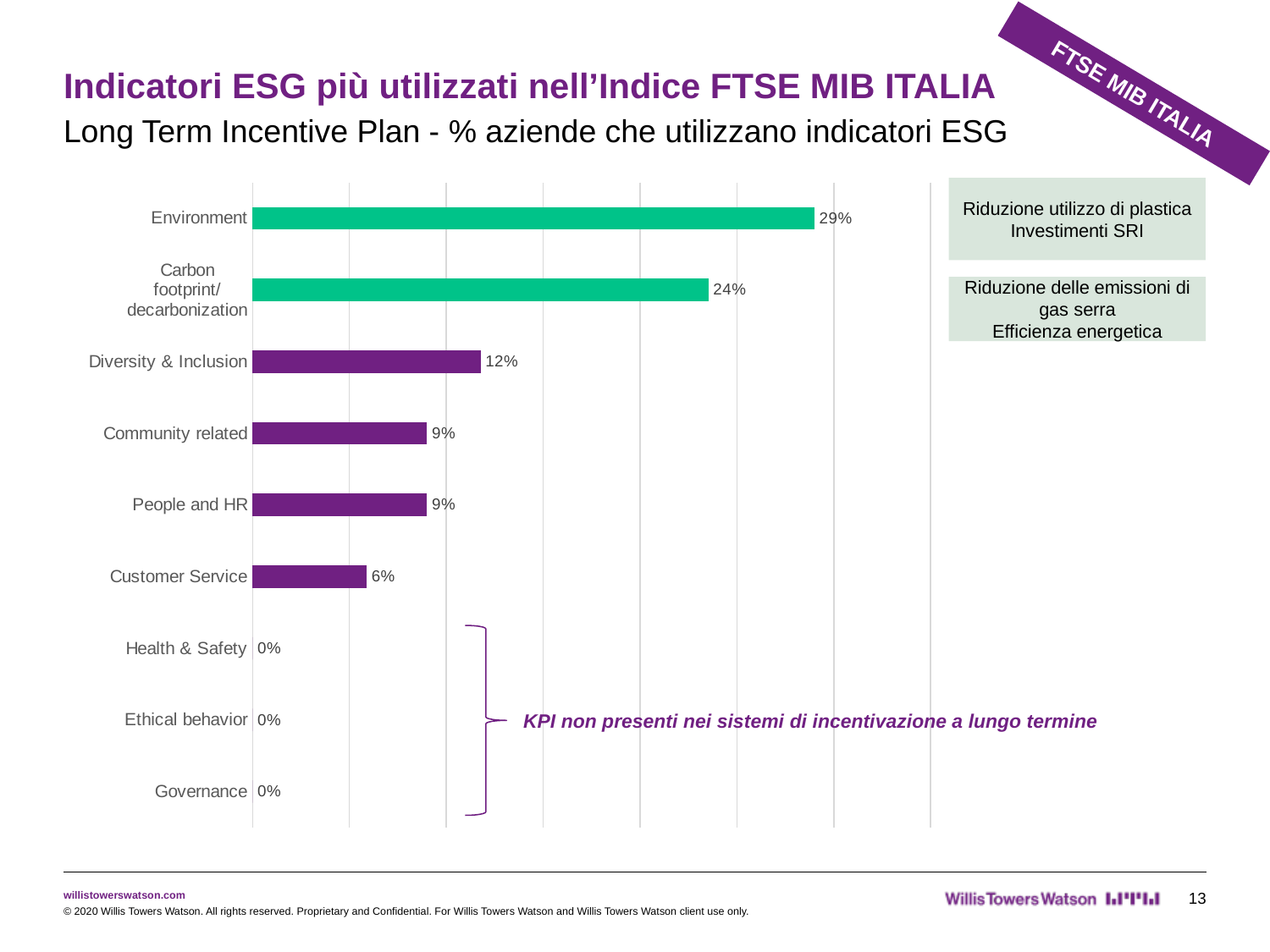
Which is larger, the value for Community related or the value for Customer Service? Community related Which category has the highest value in the chart? Environment How many categories have a value of 0%? 3 What is the difference between the values for Environment and Carbon footprint/decarbonization? 5% Which categories are marked as KPIs not present in long-term incentive systems? Health & Safety, Ethical behavior, Governance What percentage of companies use Environment indicators in their Long Term Incentive Plan? 29% What is the value shown for Customer Service? 6% How many categories are shown in the chart? 9 What type of chart is shown on the slide? Bar chart What is the value shown for Diversity & Inclusion? 12% What is the difference between the values for Diversity & Inclusion and Customer Service? 6% What is the value shown for Carbon footprint/decarbonization? 24%